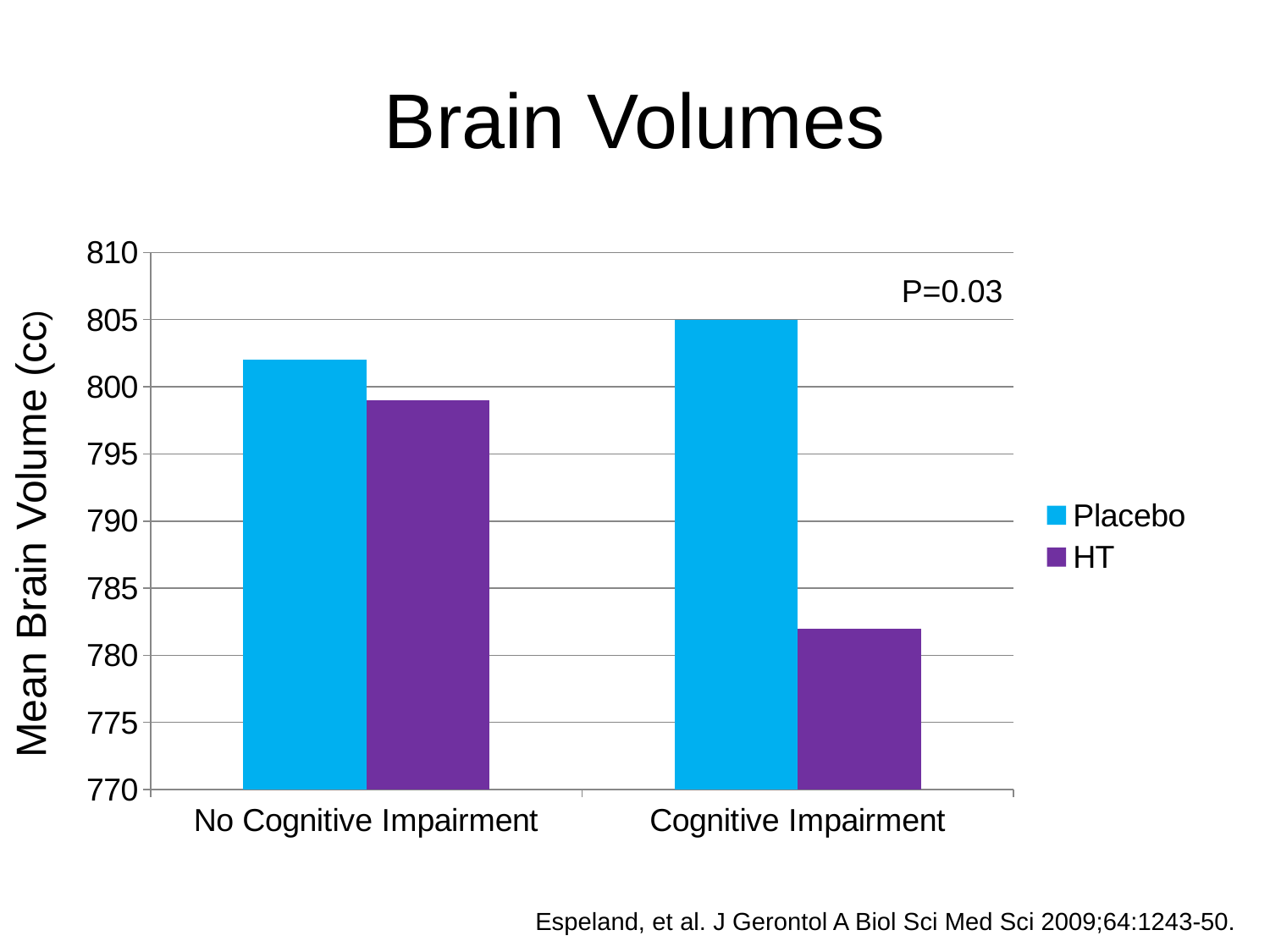
How many series does the legend list? 2 Is the HT value for Cognitive Impairment greater or less than 785? less In the Cognitive Impairment group, which is larger, Placebo or HT? Placebo Is the Placebo value for No Cognitive Impairment greater or less than 800? greater Which bar is the shortest in the chart? HT, Cognitive Impairment What kind of chart is shown on the slide? bar chart Is the HT value for Cognitive Impairment greater or less than 780? greater How many categories are shown on the x axis? 2 What is the label on the y axis? Mean Brain Volume (cc) Which bar is the tallest in the chart? Placebo, Cognitive Impairment What is the title of the chart? Brain Volumes In the No Cognitive Impairment group, which is larger, Placebo or HT? Placebo